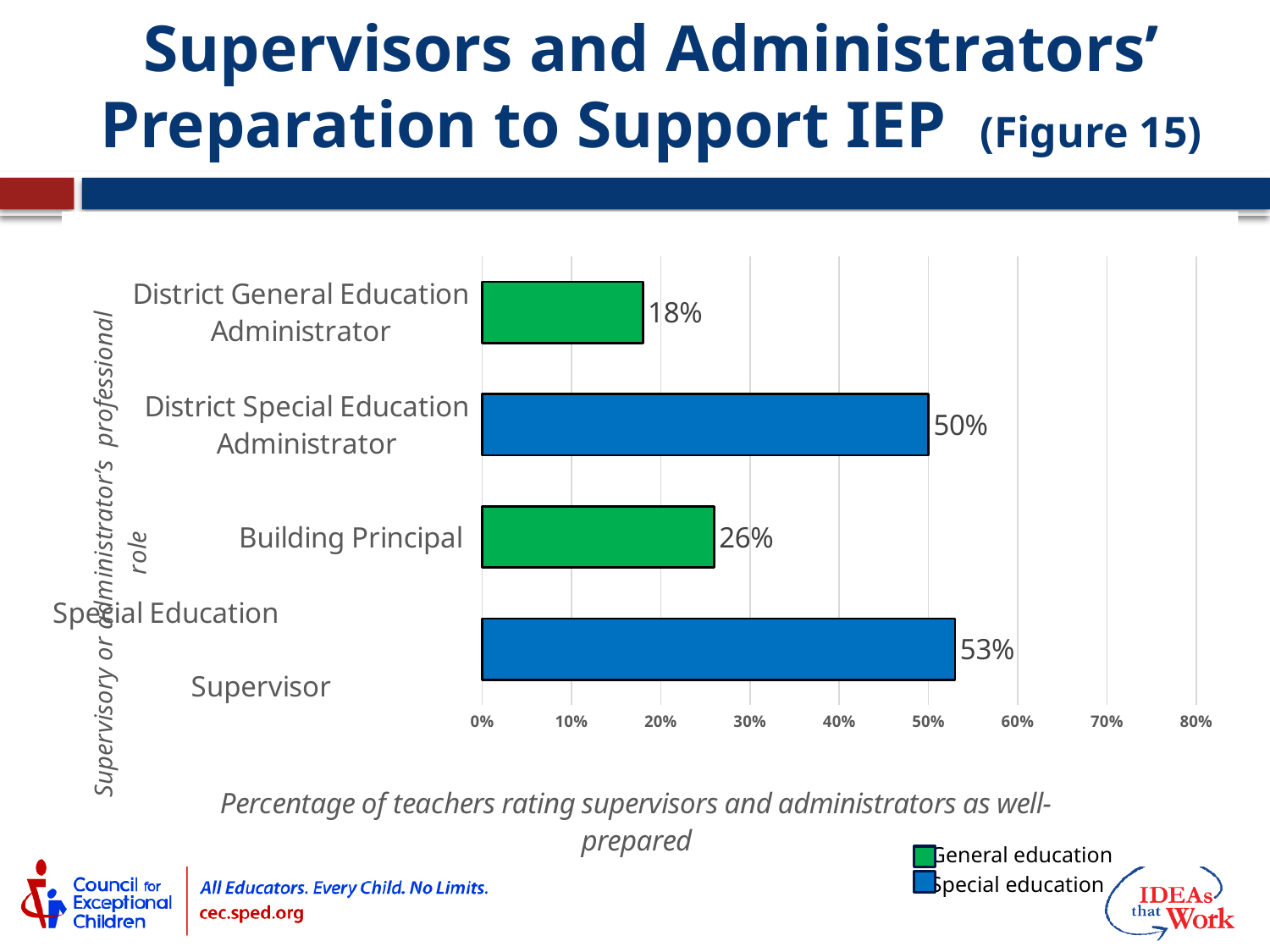
What is the difference between the values for the Special Education Supervisor and the District General Education Administrator? 35% What is the difference between the values for the District Special Education Administrator and the Building Principal? 24% What is the value shown for the Building Principal? 26% How many series does the legend list? 2 Which has a higher value, the Building Principal or the District General Education Administrator? Building Principal How many roles are shown on the chart? 4 Which role has the highest percentage of teachers rating it as well-prepared? Special Education Supervisor What is the value shown for the Special Education Supervisor? 53% What type of chart is shown on the slide? Bar chart What percentage of teachers rated the District General Education Administrator as well-prepared? 18% What is the value shown for the District Special Education Administrator? 50% Which role has the lowest percentage of teachers rating it as well-prepared? District General Education Administrator